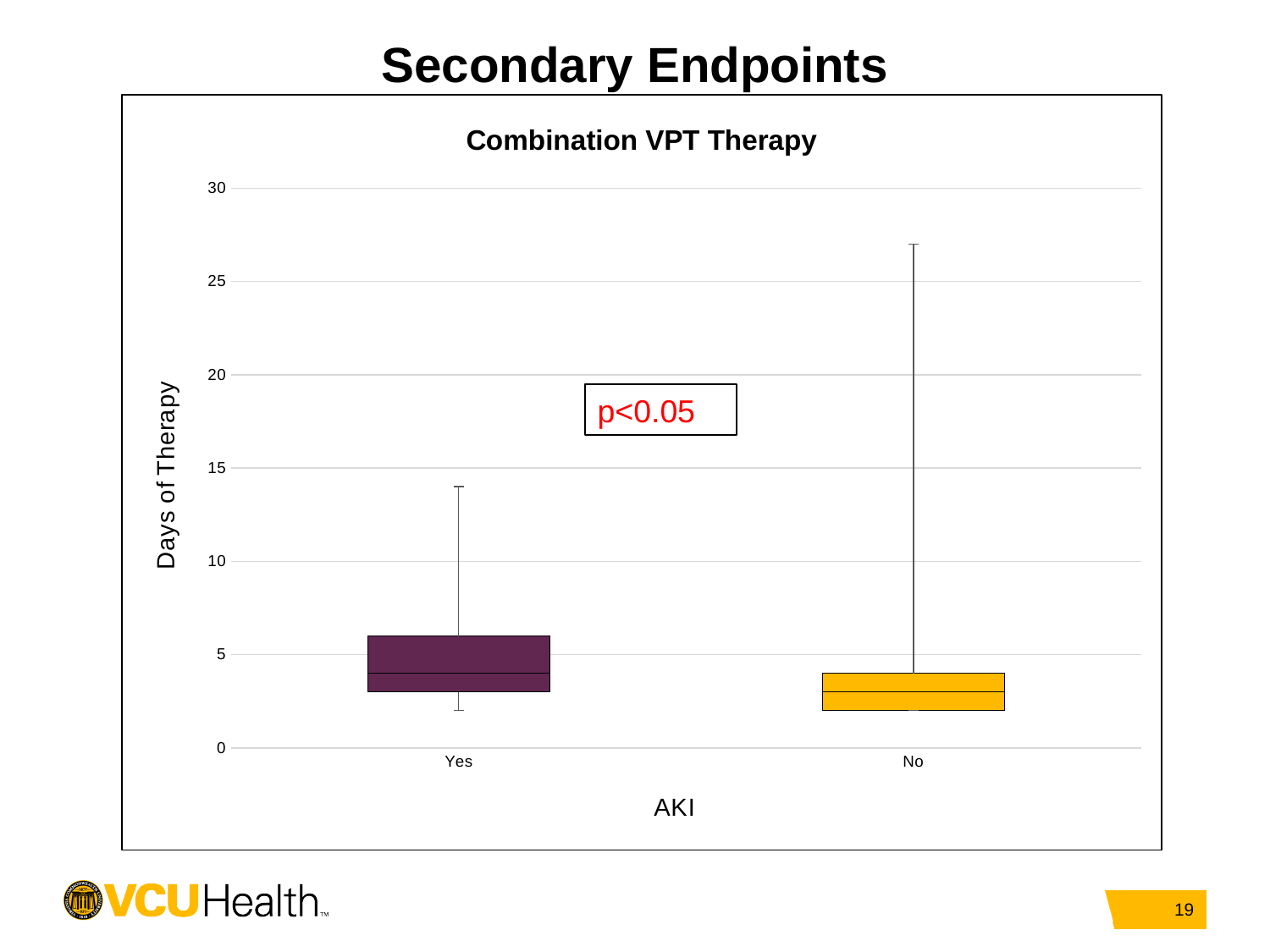
Is the top of the upper whisker for Yes greater or less than 10? greater Is the top of the box for Yes greater or less than 5? greater Which category has the higher median, Yes or No? Yes What is the y-axis label of the chart? Days of Therapy Which category has the higher upper whisker, Yes or No? No Is the top of the box for No greater or less than 5? less How many categories are shown on the x axis? 2 What kind of chart is shown on the slide? Box-and-whisker plot What is the title of the chart? Combination VPT Therapy